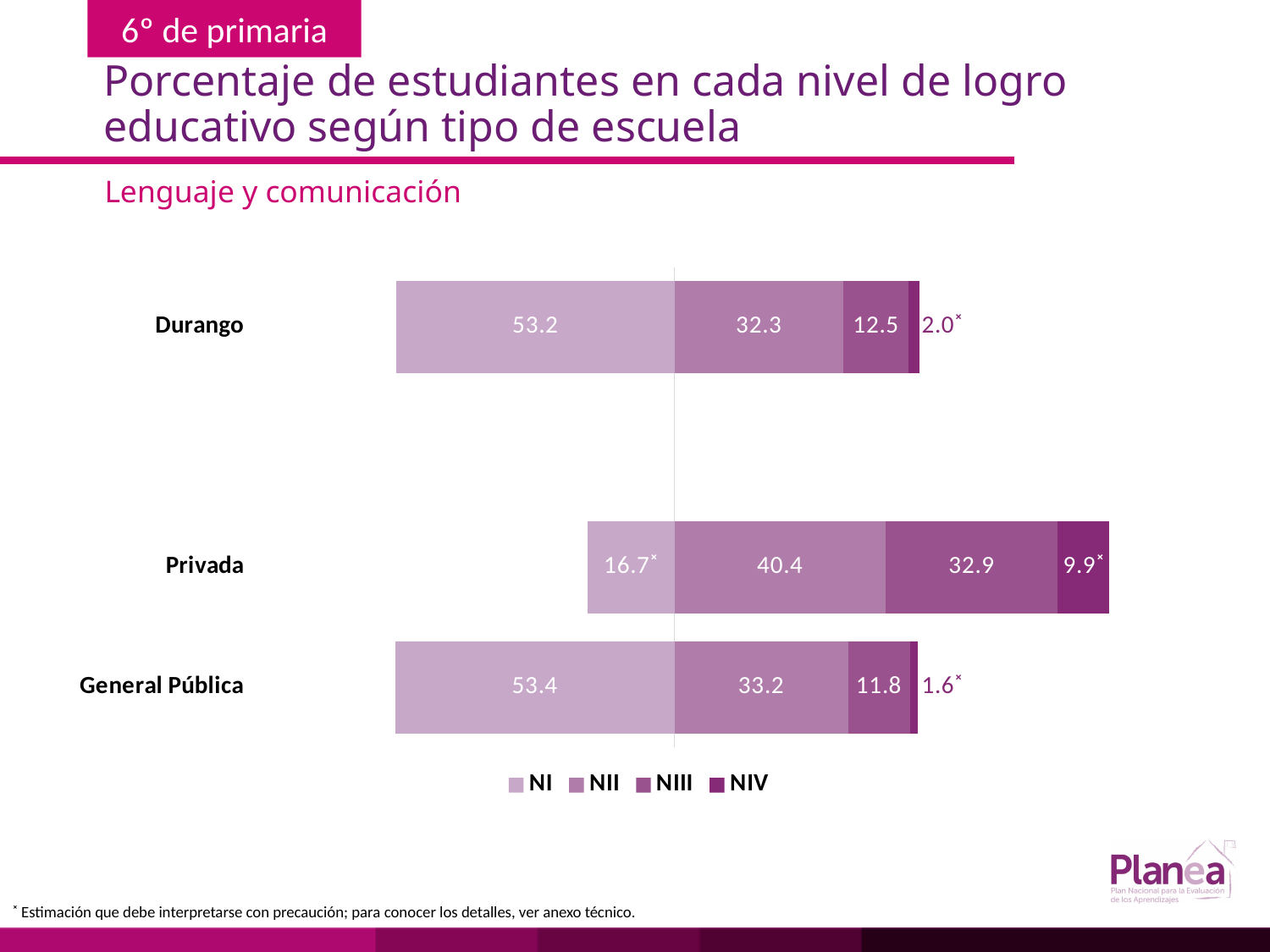
What is the NIII value for General Pública schools? 11.8 What is the NIII value for Privada schools? 32.9 What is the NII value for Privada schools? 40.4 Which is larger, the NIII value for Privada or the NIII value for Durango? Privada What is the total of the stacked bar for Privada? 99.9 What kind of chart is shown on the slide? Stacked bar chart Which school type has the highest NI percentage? General Pública How many school types (categories) are shown in the chart? 3 What is the difference between the NII values for General Pública and Durango? 0.9 Which school type has the lowest NI percentage? Privada What percentage of Durango students are at level NI in Lenguaje y comunicación? 53.2 How many series does the legend list? 4